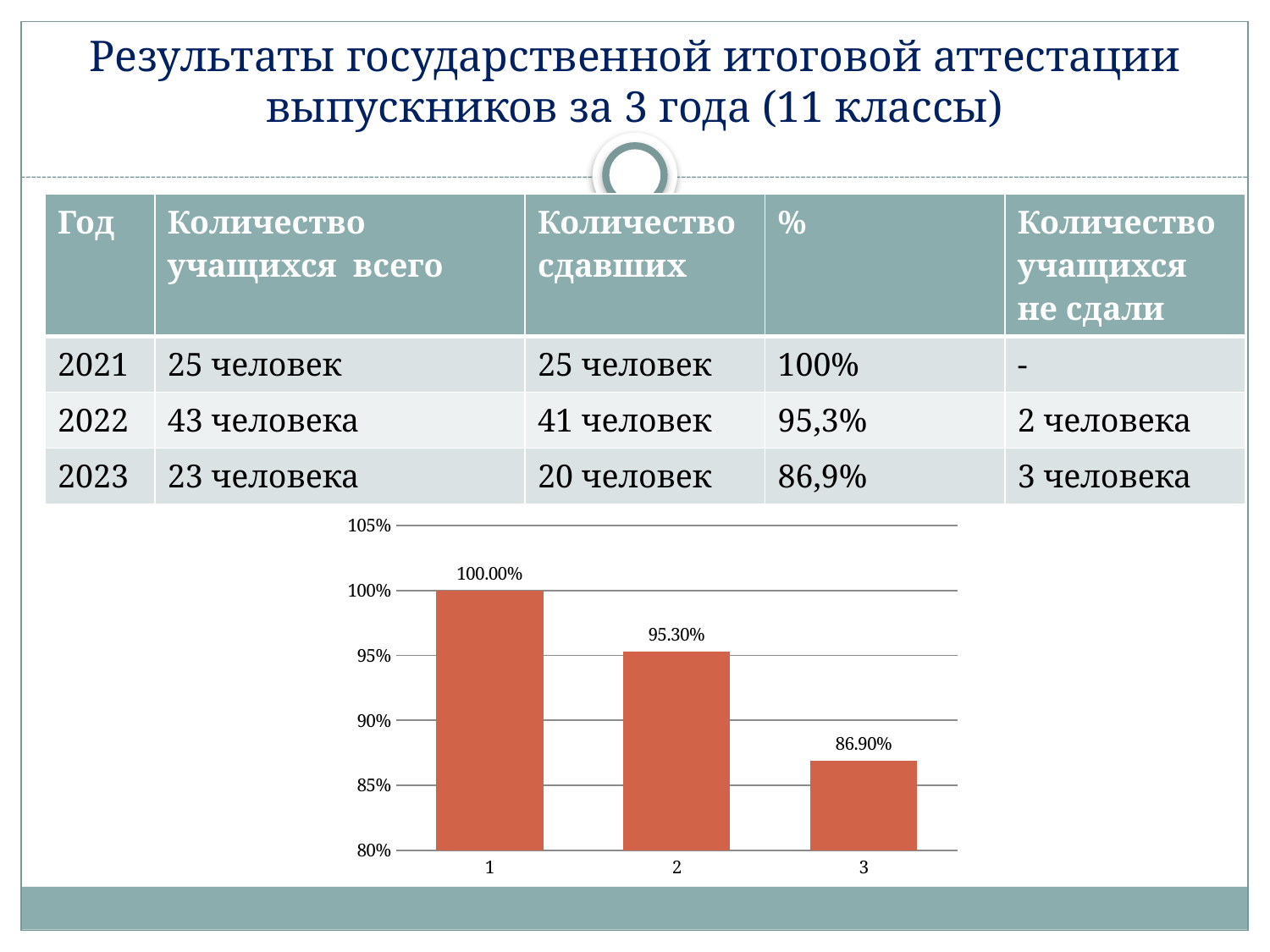
Is the value for category 3 greater or less than 90%? less How many bars are plotted in the chart? 3 Which category has the lowest bar? 3 What is the value of the bar for category 3? 86.90% What is the value of the bar for category 2? 95.30% What kind of chart is shown on the slide? bar chart What is the difference between the values for category 1 and category 3? 13.10% What is the difference between the values for category 2 and category 3? 8.40% Which category has the highest bar? 1 What is the value of the bar for category 1? 100.00% Which is larger, the value for category 2 or the value for category 3? category 2 Do the values rise or fall from category 1 to category 3? fall